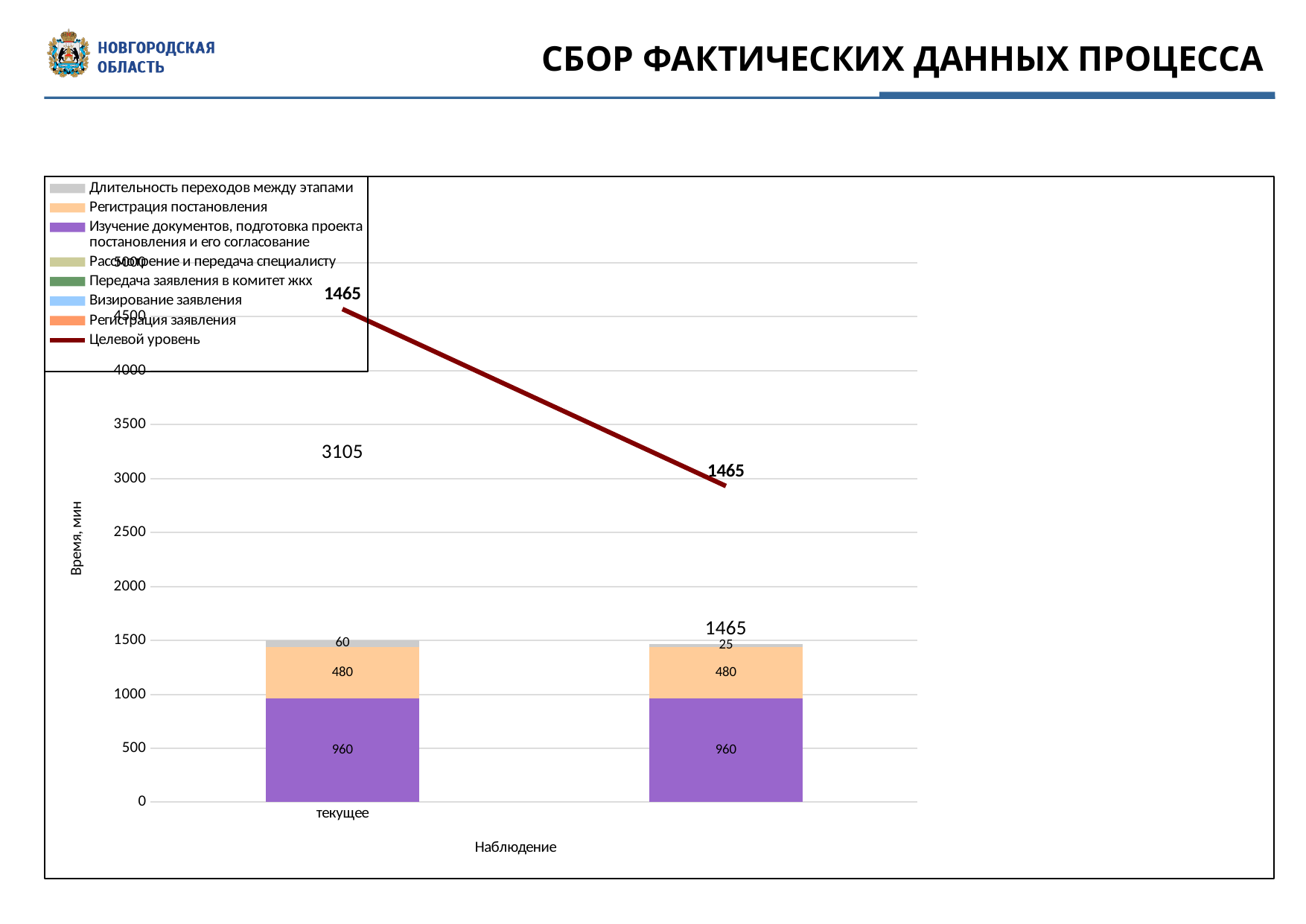
How many bars are plotted in the chart? 2 What is the value of 'Изучение документов, подготовка проекта постановления и его согласование' for the 'текущее' bar? 960 What is the total printed above the right-hand bar? 1465 What is the value of 'Длительность переходов между этапами' for the 'текущее' bar? 60 What value is labelled on the 'Целевой уровень' line? 1465 What is the difference in 'Длительность переходов между этапами' between the 'текущее' bar (60) and the right-hand bar (25)? 35 What kind of chart is shown on the slide? Stacked bar chart with a target line What is the value of 'Длительность переходов между этапами' for the right-hand bar? 25 What is the title of the vertical axis? Время, мин How many entries does the chart legend list? 8 What is the value of 'Регистрация постановления' for the 'текущее' bar? 480 Which bar has the larger value for 'Длительность переходов между этапами', the 'текущее' bar or the right-hand bar? текущее